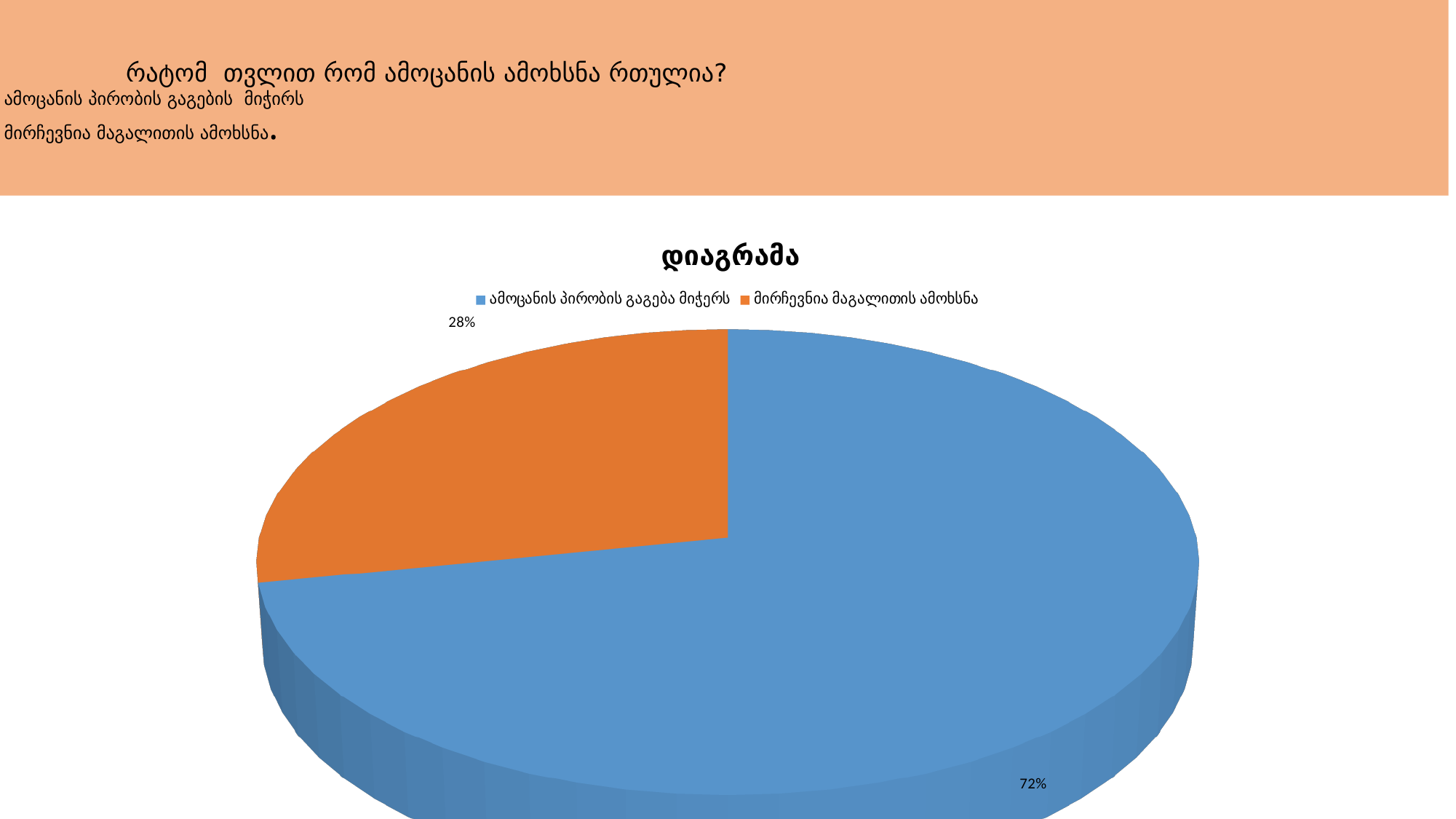
Which is larger: the share for "ამოცანის პირობის გაგება მიჭერს" or for "მირჩევნია მაგალითის ამოხსნა"? ამოცანის პირობის გაგება მიჭერს How many slices does the pie chart have? 2 What is the difference in percentage points between "ამოცანის პირობის გაგება მიჭერს" and "მირჩევნია მაგალითის ამოხსნა"? 44 What colour is the slice for "მირჩევნია მაგალითის ამოხსნა"? orange What is the title of the chart? დიაგრამა Which category has the smallest share of the pie? მირჩევნია მაგალითის ამოხსნა Which category has the largest share of the pie? ამოცანის პირობის გაგება მიჭერს What percentage is shown for "ამოცანის პირობის გაგება მიჭერს"? 72% What kind of chart is shown on the slide? pie chart What share of the pie does the blue slice represent? 72% How many entries does the legend list? 2 What percentage is shown for "მირჩევნია მაგალითის ამოხსნა"? 28%